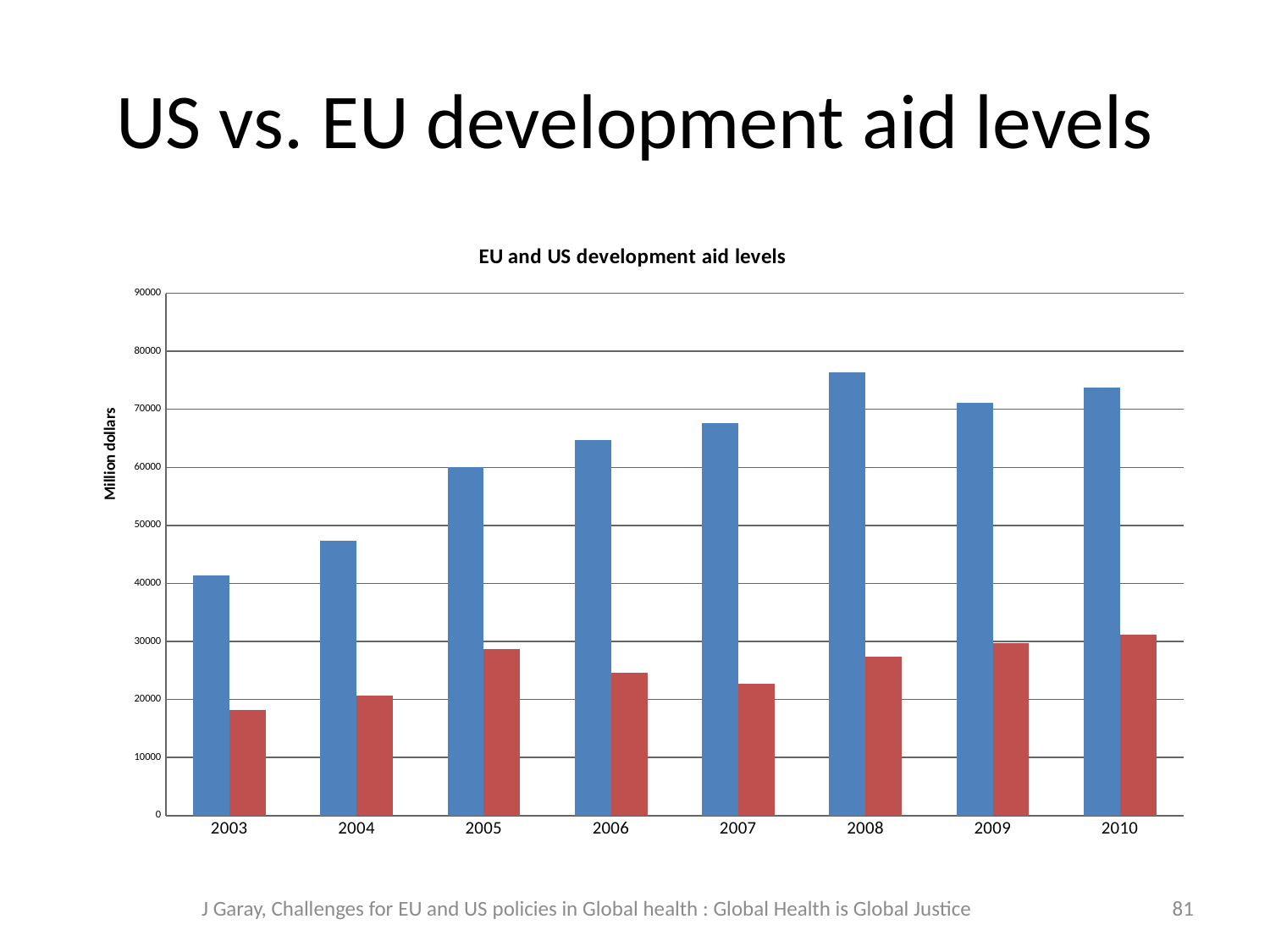
What is the label on the vertical axis of the chart? Million dollars In 2006, which bar is taller, the blue bar or the red bar? the blue bar In which year is the blue bar the shortest? 2003 What is the title of the chart? EU and US development aid levels Is the value of the blue bar for 2003 greater or less than 50000? less Do the blue bars rise or fall from 2003 to 2008? rise Is the value of the red bar for 2003 greater or less than 20000? less In which year is the red bar the shortest? 2003 In which year is the blue bar the tallest? 2008 How many years are shown along the x axis of the chart? 8 What kind of chart is shown on the slide? bar chart Is the value of the blue bar for 2008 greater or less than 70000? greater